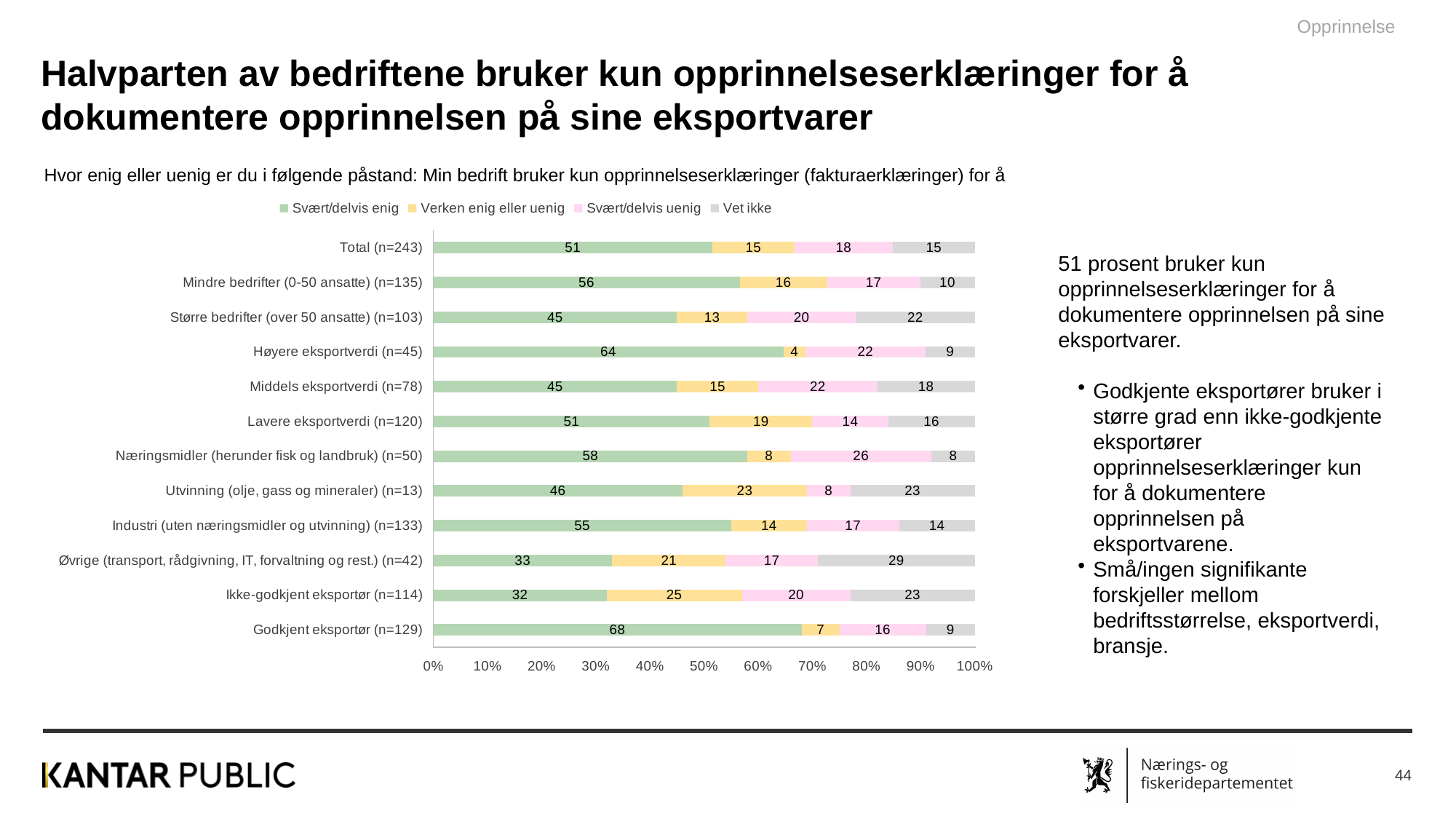
Which has a larger "Svært/delvis enig" value: Høyere eksportverdi (n=45) or Middels eksportverdi (n=78)? Høyere eksportverdi (n=45) Which category has the highest value for "Vet ikke"? Øvrige (transport, rådgivning, IT, forvaltning og rest.) (n=42) What is the difference between the "Svært/delvis enig" values for Godkjent eksportør (n=129) and Ikke-godkjent eksportør (n=114)? 36 Which category has the highest value for "Svært/delvis enig"? Godkjent eksportør (n=129) What is the value for "Vet ikke" for Større bedrifter (over 50 ansatte) (n=103)? 22 What is the value for "Verken enig eller uenig" for Høyere eksportverdi (n=45)? 4 Which category has the highest value for "Svært/delvis uenig"? Næringsmidler (herunder fisk og landbruk) (n=50) How many series does the legend list? 4 How many categories are shown on the y axis of the chart? 12 What is the value for "Svært/delvis enig" for Total (n=243)? 51 What kind of chart is shown on the slide? Stacked bar chart What is the total of the stacked bar for Godkjent eksportør (n=129)? 100